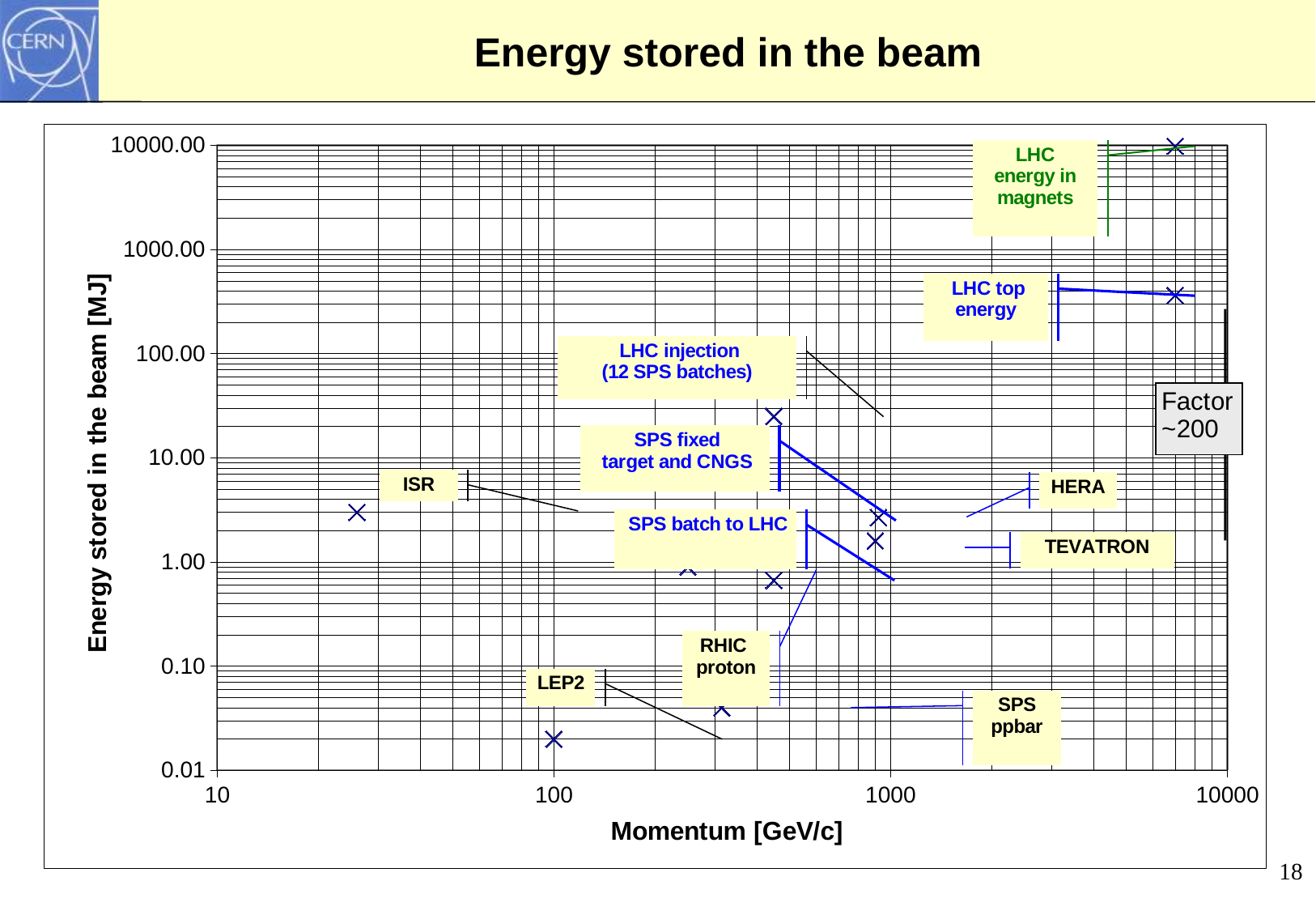
Which has the larger stored beam energy, LHC top energy or HERA? LHC top energy What is the title of the chart? Energy stored in the beam Is the value for LHC energy in magnets greater or less than 1000.00 MJ? greater Which has the larger stored beam energy, ISR or LEP2? ISR Is the value for ISR greater or less than 1.00 MJ? greater Which labelled point has the highest energy stored in the beam? LHC energy in magnets What is the label of the x axis? Momentum [GeV/c] Is the value for LHC injection (12 SPS batches) greater or less than 10.00 MJ? greater What kind of chart is shown on the slide? Scatter chart (log-log plot) Do the stored beam energies generally rise or fall as momentum increases along the x axis? rise